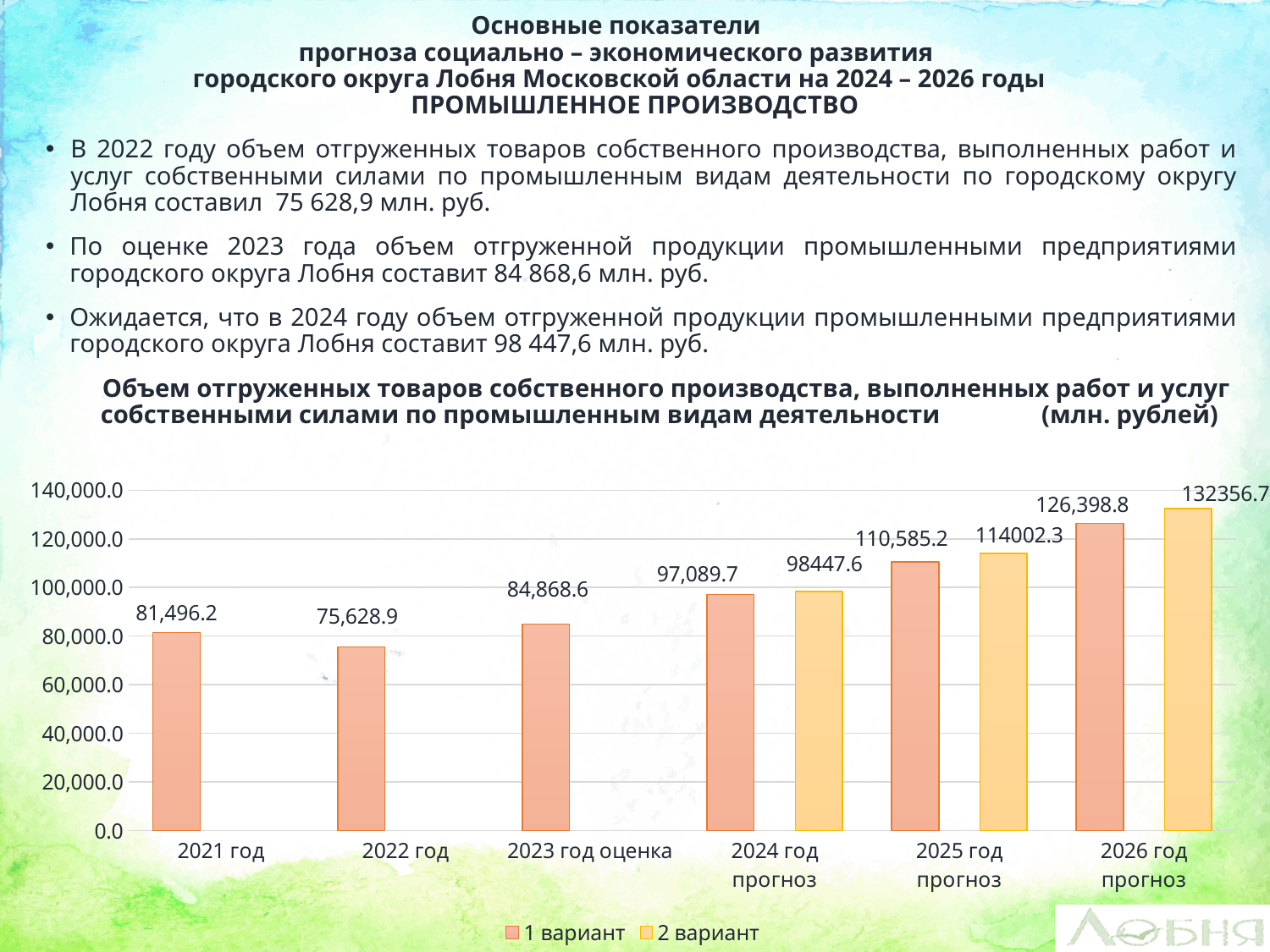
How many categories are shown on the x axis of the chart? 6 Which is larger for 2025 год прогноз: 1 вариант or 2 вариант? 2 вариант Which category has the highest value in the chart? 2026 год прогноз What is the difference between the 2 вариант and 1 вариант values for 2024 год прогноз? 1357.9 Is the value for 2023 год оценка greater or less than 80,000.0? greater How many series does the chart legend list? 2 Which category has the lowest value in the chart? 2022 год What is the value of the 2 вариант series for 2026 год прогноз? 132356.7 What is the value for 2022 год in the chart? 75,628.9 What is the value for 2021 год in the chart? 81,496.2 What kind of chart is shown on the slide? bar chart What is the value of the 1 вариант series for 2025 год прогноз? 110,585.2